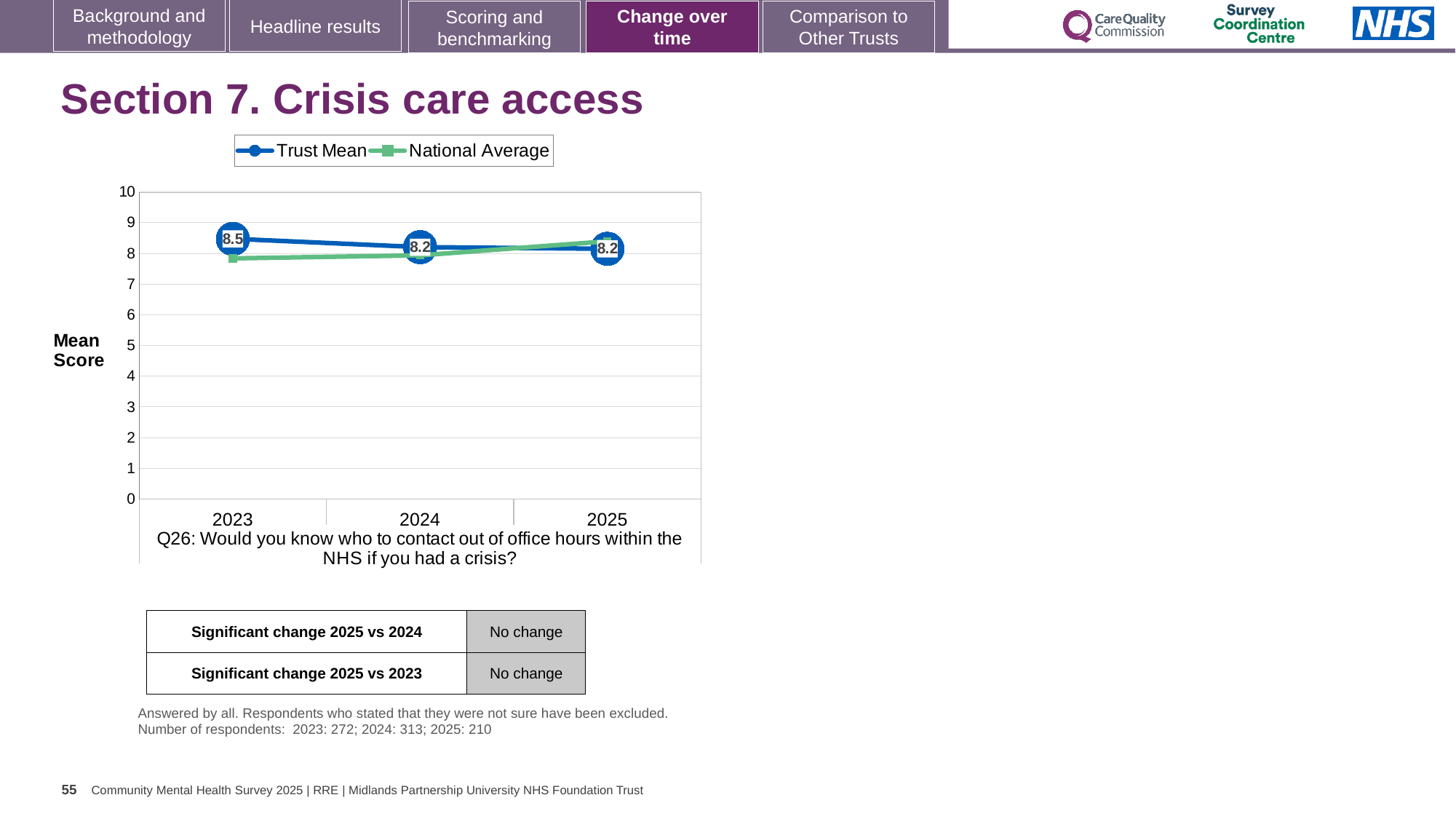
Is the National Average value for 2025 greater or less than 8? greater What is the Trust Mean value for 2024? 8.2 Does the Trust Mean rise or fall from 2023 to 2025? Fall How many years are plotted on the x axis? 3 In which year is the Trust Mean highest? 2023 What kind of chart is shown on the slide? Line chart What is the Trust Mean value for 2025? 8.2 In 2023, which series has the higher value, Trust Mean or National Average? Trust Mean How many series does the legend list? 2 What is the difference between the Trust Mean in 2023 and in 2024? 0.3 Which is larger, the Trust Mean in 2023 or the Trust Mean in 2025? 2023 What is the Trust Mean value for 2023? 8.5